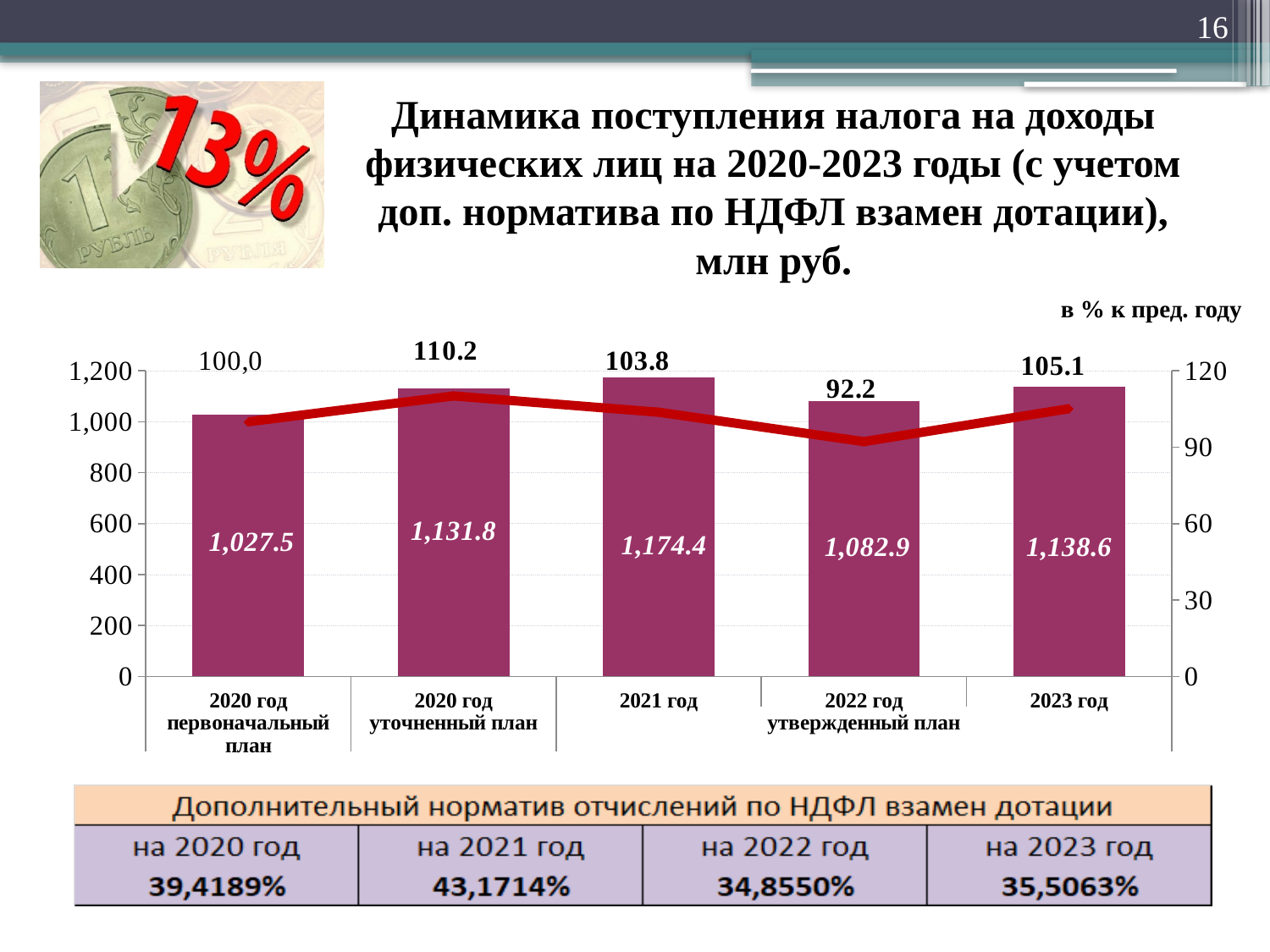
What is the difference between the bar values for 2023 год and 2022 год утвержденный план? 55.7 What is the difference between the bar values for 2021 год and 2020 год уточненный план? 42.6 Which is larger, the bar value for 2023 год or for 2020 год уточненный план? 2023 год What is the value of the bar for 2022 год утвержденный план? 1,082.9 What kind of chart is shown on the slide? Bar chart with a line How many categories are shown on the x axis of the chart? 5 Which category has the highest bar value? 2021 год What is the value of the bar for 2020 год уточненный план? 1,131.8 What is the value of the line (в % к пред. году) for 2023 год? 105.1 Which category has the lowest value on the line (в % к пред. году)? 2022 год утвержденный план What is the value of the bar for 2021 год? 1,174.4 Which category has the lowest bar value? 2020 год первоначальный план